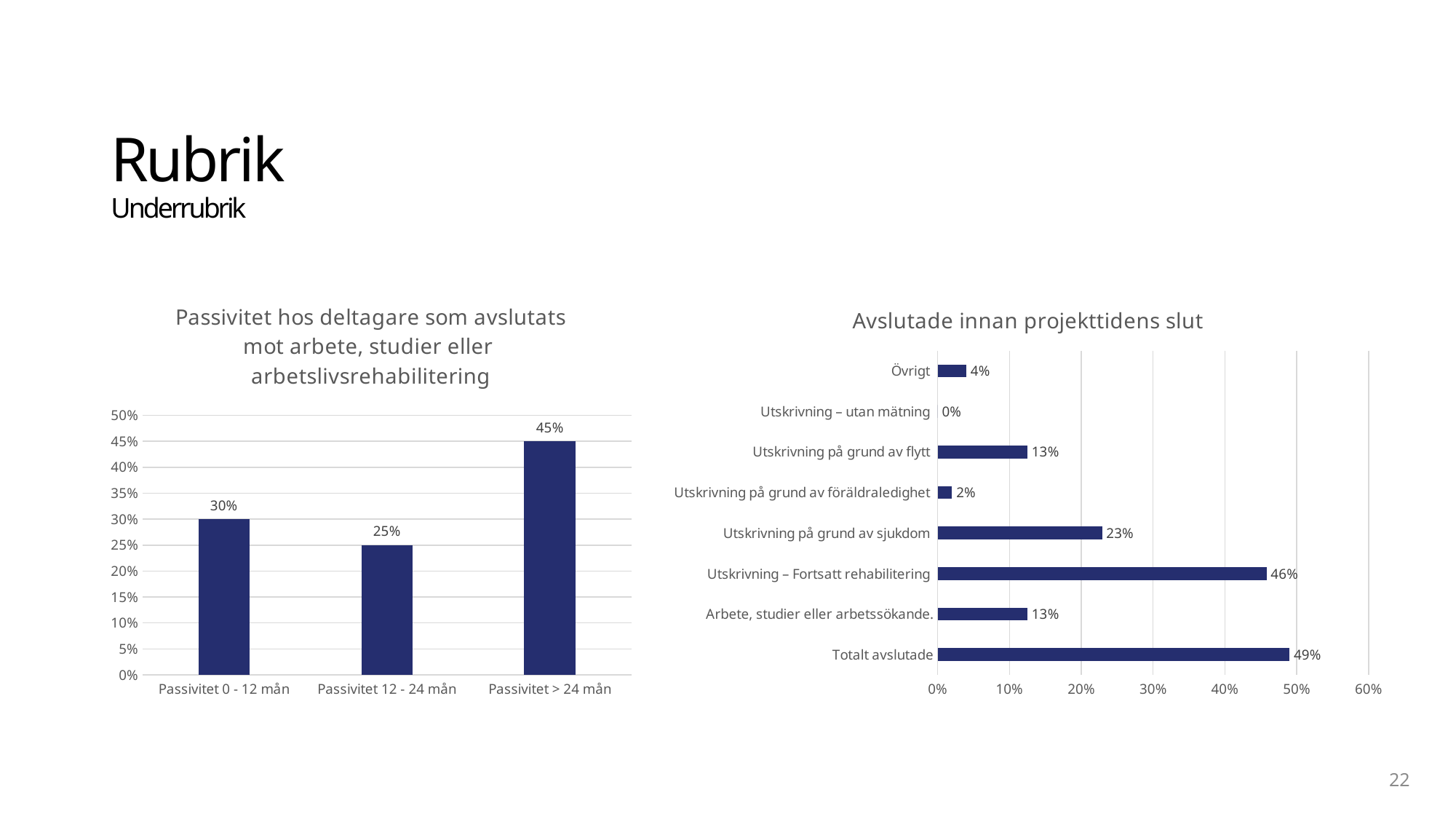
In the chart 'Passivitet hos deltagare som avslutats mot arbete, studier eller arbetslivsrehabilitering', how many categories are shown? 3 In the chart 'Passivitet hos deltagare som avslutats mot arbete, studier eller arbetslivsrehabilitering', which category has the highest value? Passivitet > 24 mån What kind of chart is 'Avslutade innan projekttidens slut'? Bar chart In the chart 'Avslutade innan projekttidens slut', what is the value for Utskrivning – Fortsatt rehabilitering? 46% In the chart 'Avslutade innan projekttidens slut', how many categories are shown? 8 In the chart 'Avslutade innan projekttidens slut', which category has the highest value? Totalt avslutade In the chart 'Avslutade innan projekttidens slut', what is the value for Utskrivning på grund av sjukdom? 23% In the chart 'Avslutade innan projekttidens slut', which category has the lowest value? Utskrivning – utan mätning In the chart 'Avslutade innan projekttidens slut', which is larger: Utskrivning på grund av flytt or Övrigt? Utskrivning på grund av flytt In the chart 'Passivitet hos deltagare som avslutats mot arbete, studier eller arbetslivsrehabilitering', what is the value for Passivitet 0 - 12 mån? 30% In the chart 'Passivitet hos deltagare som avslutats mot arbete, studier eller arbetslivsrehabilitering', which category has the lowest value? Passivitet 12 - 24 mån In the chart 'Passivitet hos deltagare som avslutats mot arbete, studier eller arbetslivsrehabilitering', what is the difference between Passivitet > 24 mån and Passivitet 12 - 24 mån? 20%